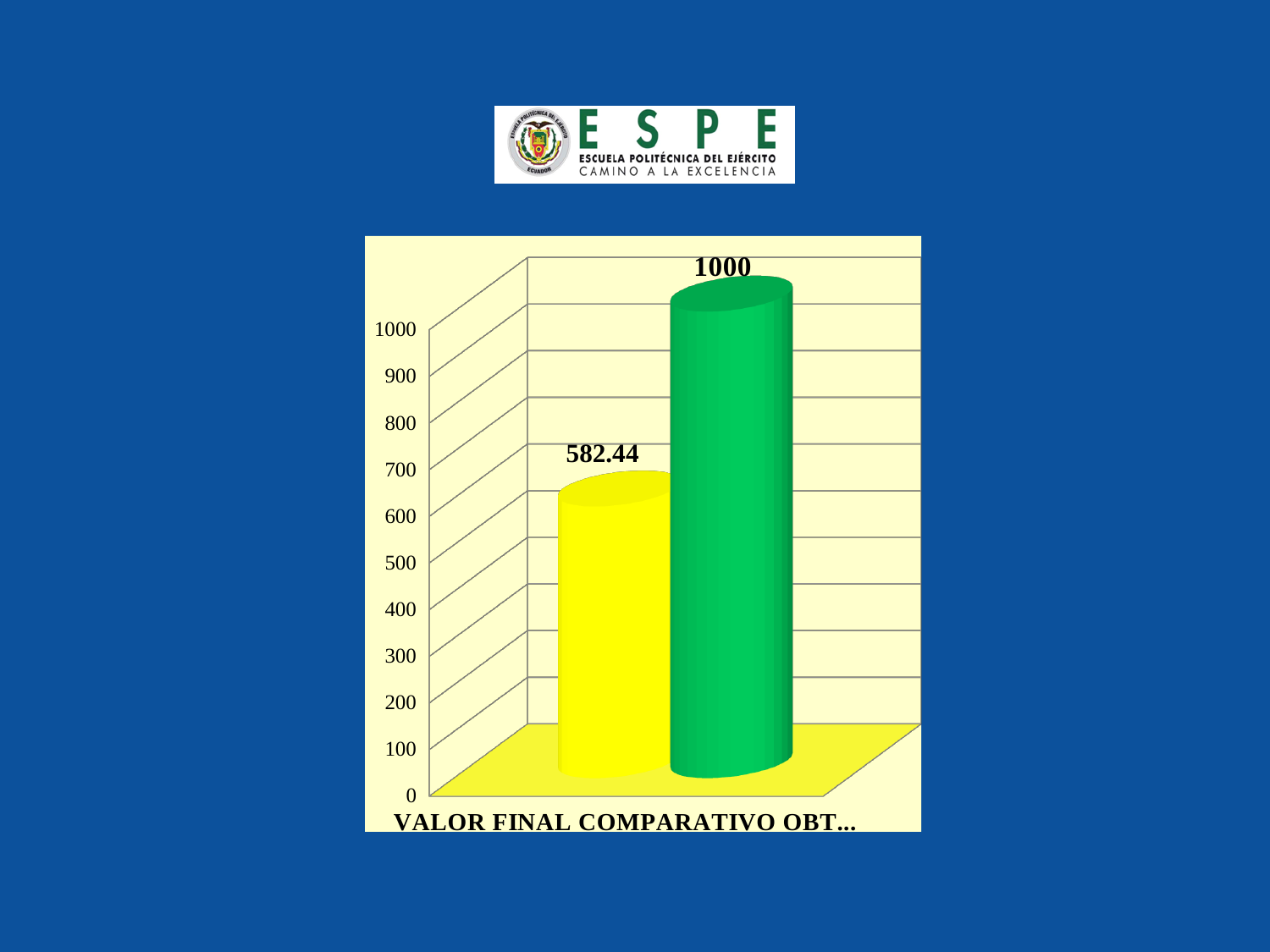
What is the difference between the value of the green bar and the value of the yellow bar? 417.56 What value is printed on the yellow bar? 582.44 Is the value of the yellow bar larger or smaller than the value of the green bar? smaller What kind of chart is shown on the slide? bar chart What value is printed on the green bar? 1000 What is the highest value shown on the vertical axis? 1000 Which bar has the highest value, the yellow one or the green one? the green bar How many bars are plotted in the chart? 2 Which bar has the lowest value, the yellow one or the green one? the yellow bar Is the value of the yellow bar greater or less than 500? greater What colours are the two bars in the chart? yellow and green